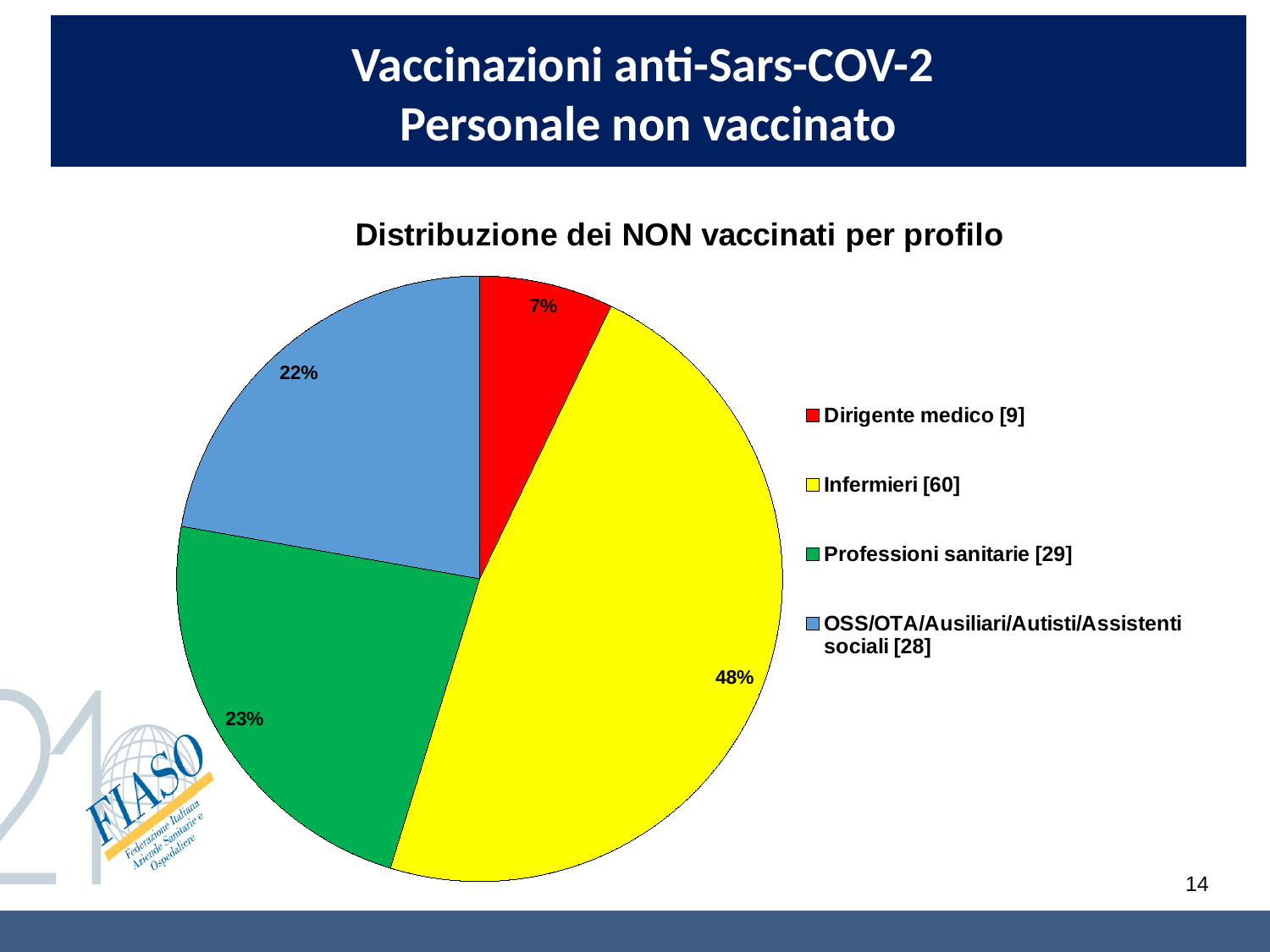
What percentage of the pie does OSS/OTA/Ausiliari/Autisti/Assistenti sociali represent? 22% What percentage of the pie does Infermieri represent? 48% How many categories does the legend list? 4 What colour is the slice for Infermieri? yellow What percentage of the pie does Dirigente medico represent? 7% Which is larger, the share for Infermieri or the share for Professioni sanitarie? Infermieri Which category has the smallest share of the pie? Dirigente medico Which category has the largest share of the pie? Infermieri What kind of chart is shown on the slide? pie chart What percentage of the pie does Professioni sanitarie represent? 23% What is the title of the chart? Distribuzione dei NON vaccinati per profilo What is the difference in percentage points between the Infermieri share and the Dirigente medico share? 41